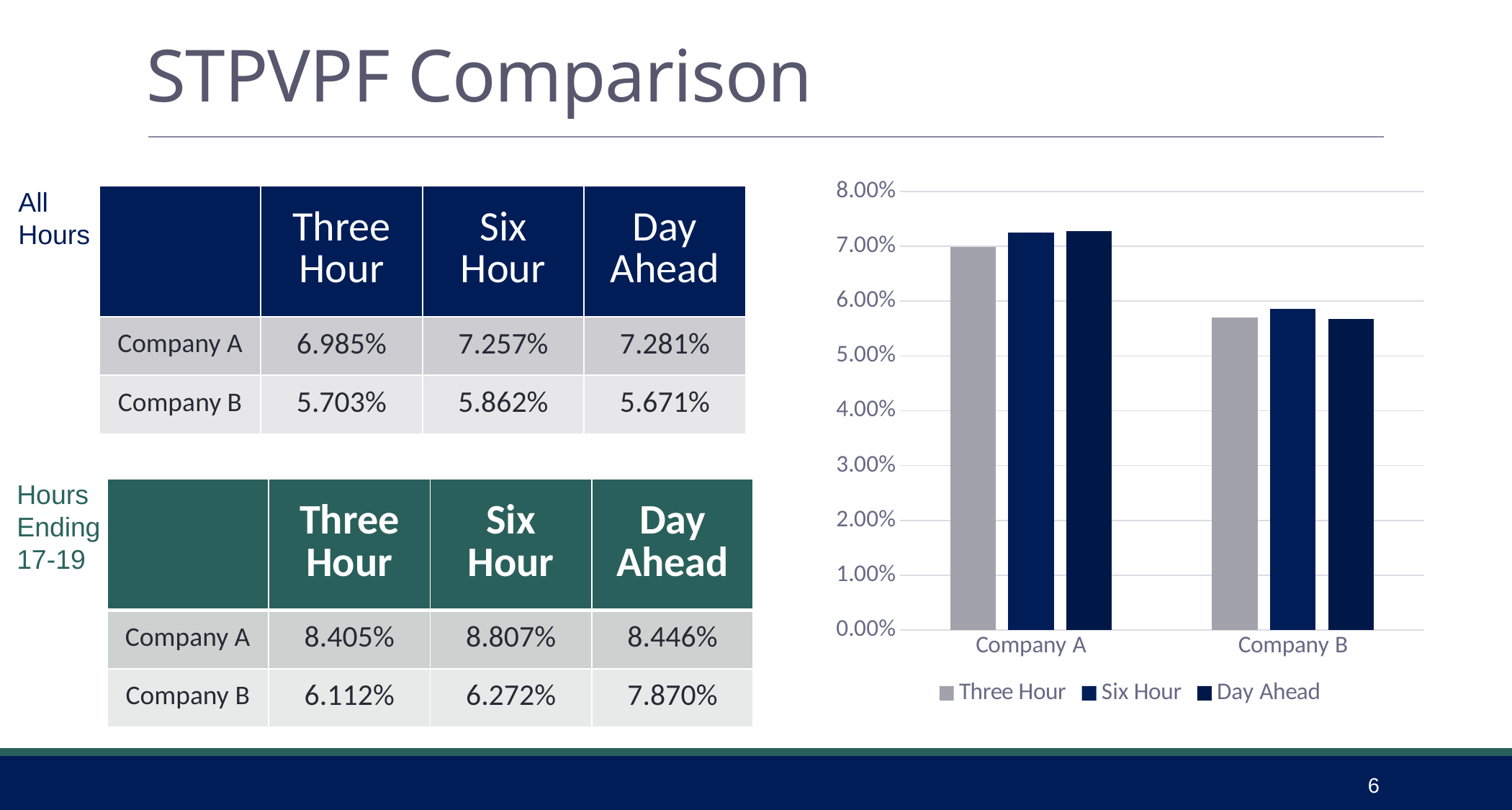
In the chart, is the Six Hour value for Company B greater or less than 6.00%? less Which series are listed in the chart's legend? Three Hour, Six Hour, Day Ahead In the chart, which company has the higher Day Ahead bar? Company A In the chart, which is larger for Company A: the Three Hour bar or the Six Hour bar? Six Hour What is the highest value shown on the chart's y axis? 8.00% How many series does the chart's legend list? 3 What kind of chart is shown on the right of the slide? bar chart In the chart, is the Three Hour value for Company B greater or less than 5.00%? greater In the chart, is the Six Hour value for Company A greater or less than 7.00%? greater In the chart, which is larger for Company B: the Six Hour bar or the Day Ahead bar? Six Hour How many companies are shown on the x axis of the chart? 2